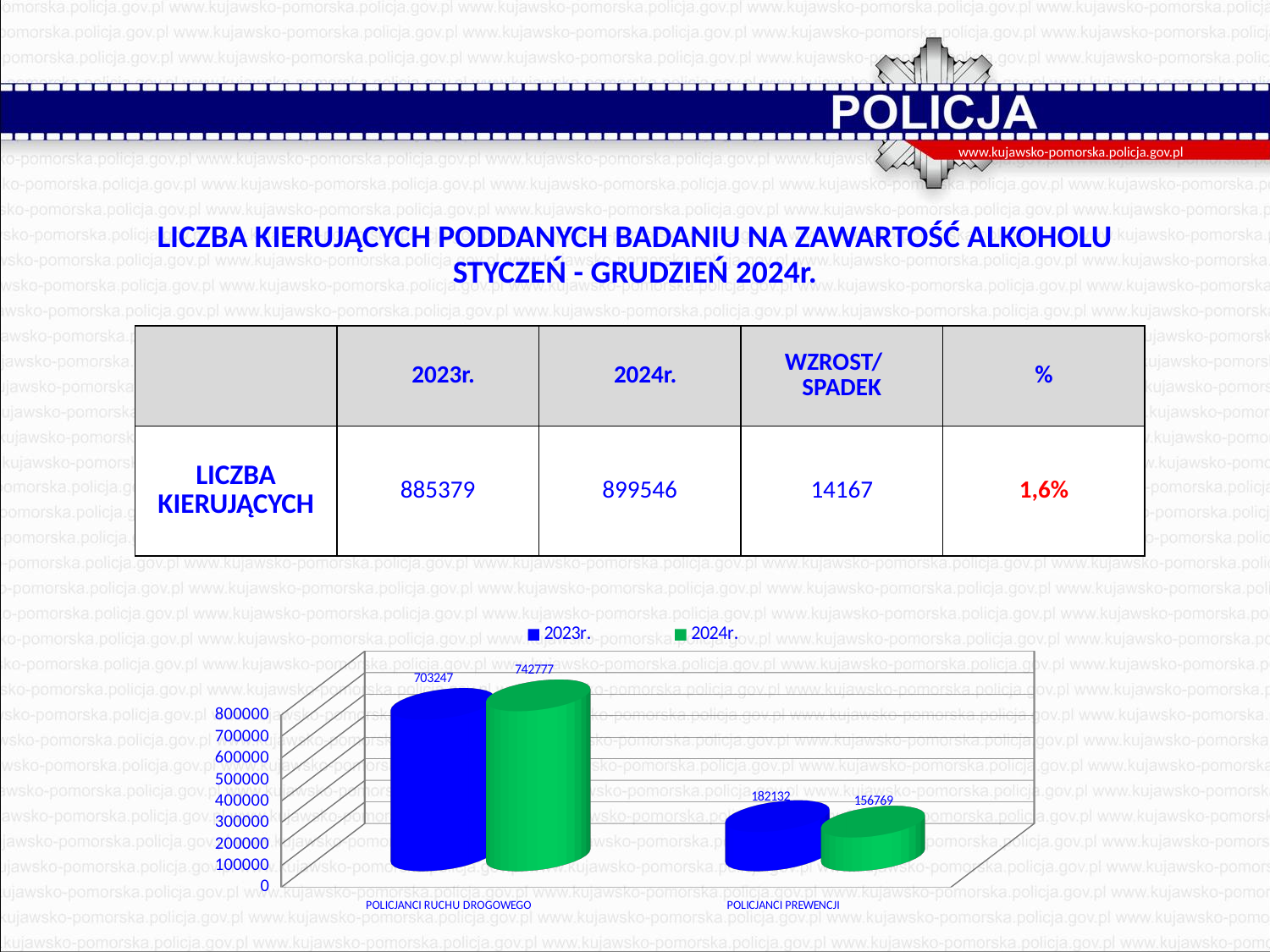
What is the value for 2024r. for POLICJANCI PREWENCJI? 156769 Which category has the highest value in the 2024r. series? POLICJANCI RUCHU DROGOWEGO What is the difference between the 2023r. and 2024r. values for POLICJANCI PREWENCJI? 25363 How many categories are shown on the x axis of the chart? 2 What kind of chart is shown on the slide? Bar chart What is the difference between the 2024r. and 2023r. values for POLICJANCI RUCHU DROGOWEGO? 39530 What is the value for 2023r. for POLICJANCI PREWENCJI? 182132 What is the value for 2023r. for POLICJANCI RUCHU DROGOWEGO? 703247 What is the value for 2024r. for POLICJANCI RUCHU DROGOWEGO? 742777 Which category has the lowest value in the 2023r. series? POLICJANCI PREWENCJI How many series does the chart legend list? 2 For POLICJANCI PREWENCJI, which series has the larger value, 2023r. or 2024r.? 2023r.